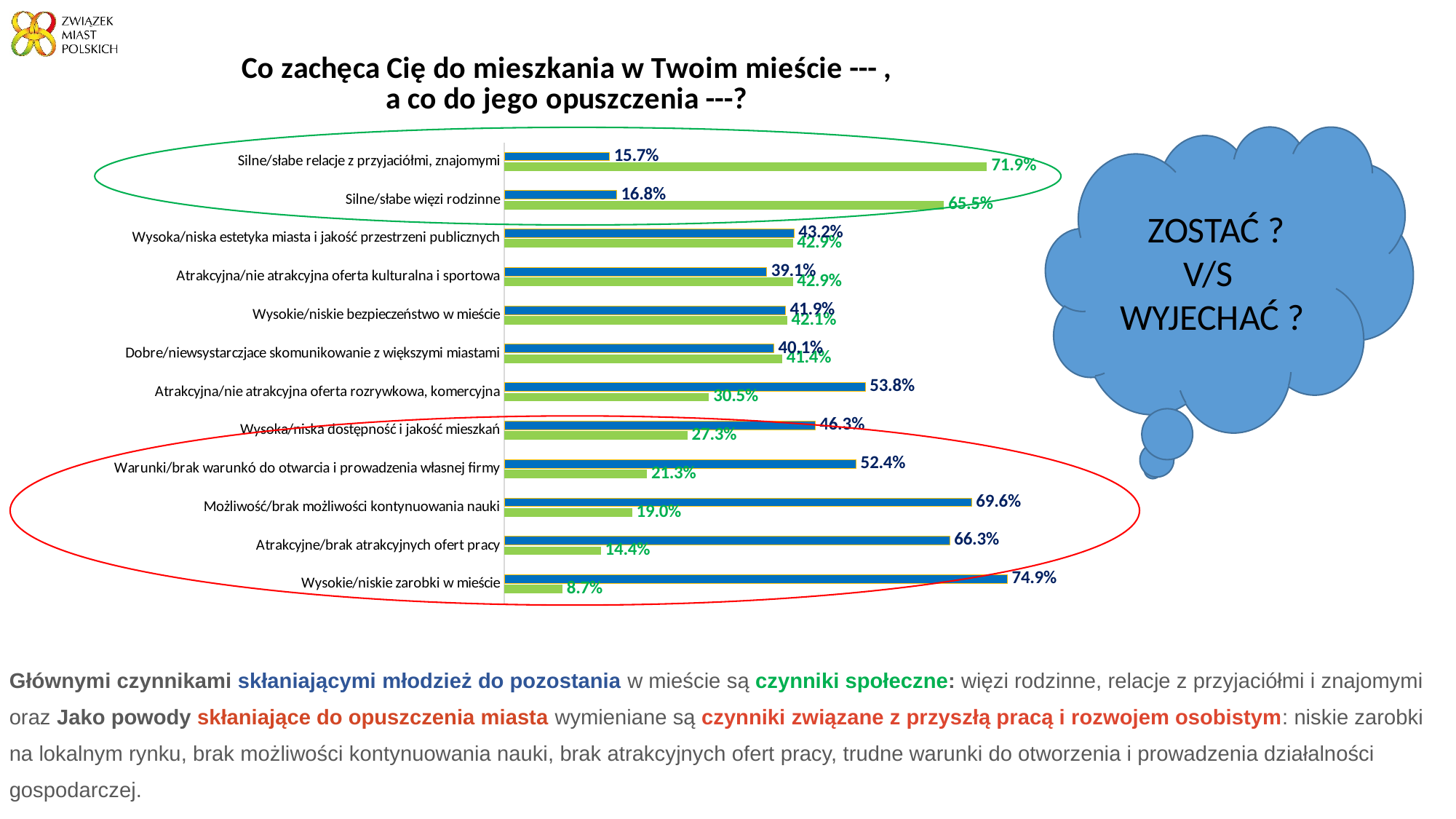
What is the value of the green bar for "Silne/słabe relacje z przyjaciółmi, znajomymi"? 71.9% How many categories are plotted in the chart? 12 Which category has the highest blue bar value? Wysokie/niskie zarobki w mieście Which category has the highest green bar value? Silne/słabe relacje z przyjaciółmi, znajomymi What is the value of the green bar for "Możliwość/brak możliwości kontynuowania nauki"? 19.0% What text appears in the blue cloud shape to the right of the chart? ZOSTAĆ ? V/S WYJECHAĆ ? What is the value of the blue bar for "Wysokie/niskie zarobki w mieście"? 74.9% For "Atrakcyjne/brak atrakcyjnych ofert pracy", which bar is larger, the blue or the green? blue What is the value of the blue bar for "Atrakcyjna/nie atrakcyjna oferta rozrywkowa, komercyjna"? 53.8% What is the difference between the green and blue bar values for "Silne/słabe relacje z przyjaciółmi, znajomymi"? 56.2 percentage points What type of chart is shown on the slide? bar chart Which category has the lowest green bar value? Wysokie/niskie zarobki w mieście